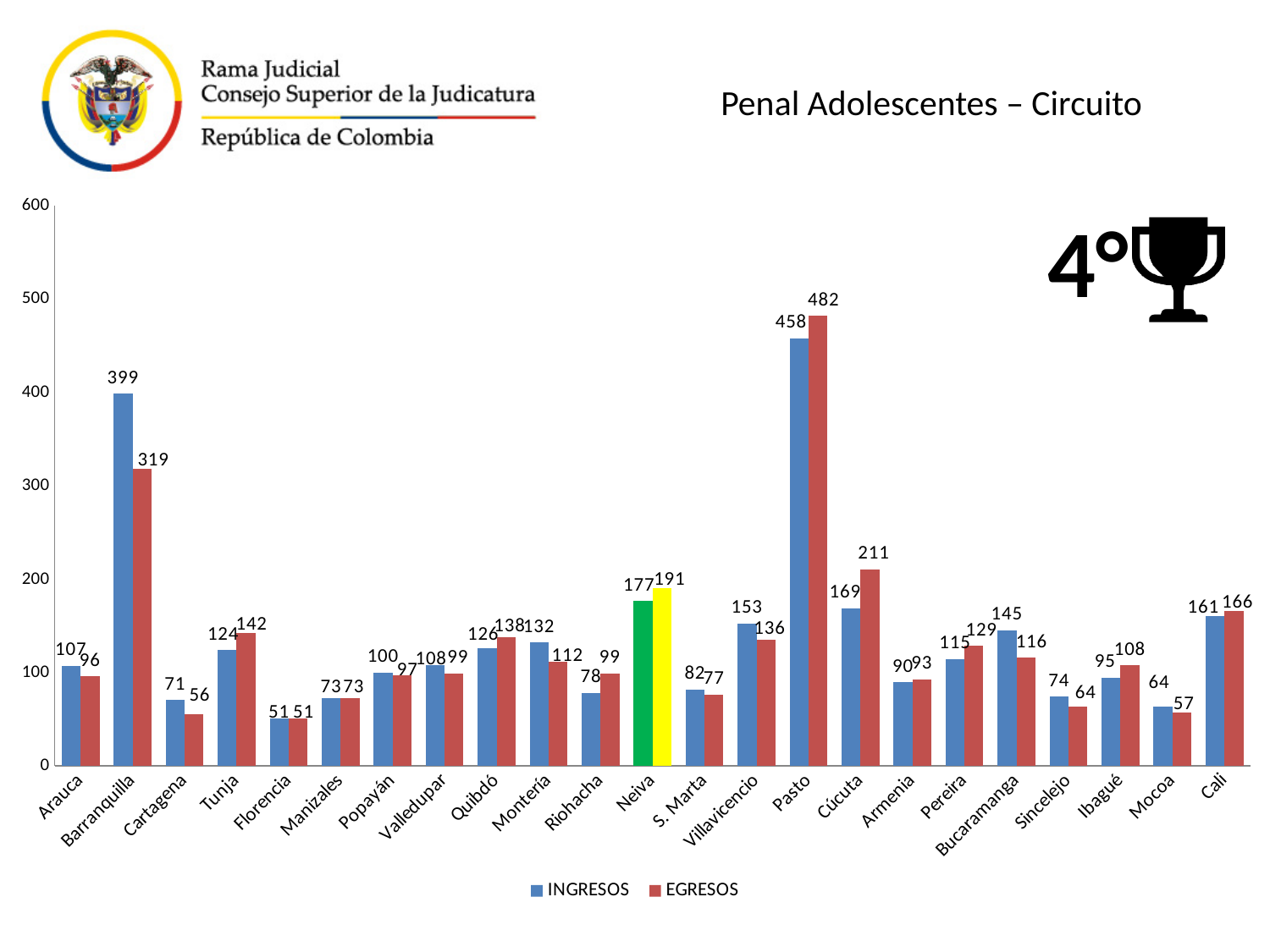
What is the difference between the INGRESOS values for Barranquilla and Cartagena? 328 What is the EGRESOS value for Neiva? 191 Which city has the lowest INGRESOS value? Florencia Which city has the highest EGRESOS value? Pasto What kind of chart is shown on the slide? Bar chart Which is larger for Bucaramanga, INGRESOS or EGRESOS? INGRESOS How many series does the legend list? 2 What is the EGRESOS value for Barranquilla? 319 What is the title of the chart? Penal Adolescentes – Circuito What is the INGRESOS value for Pasto? 458 How many cities are shown on the x axis? 23 What is the difference between the EGRESOS and INGRESOS values for Cúcuta? 42